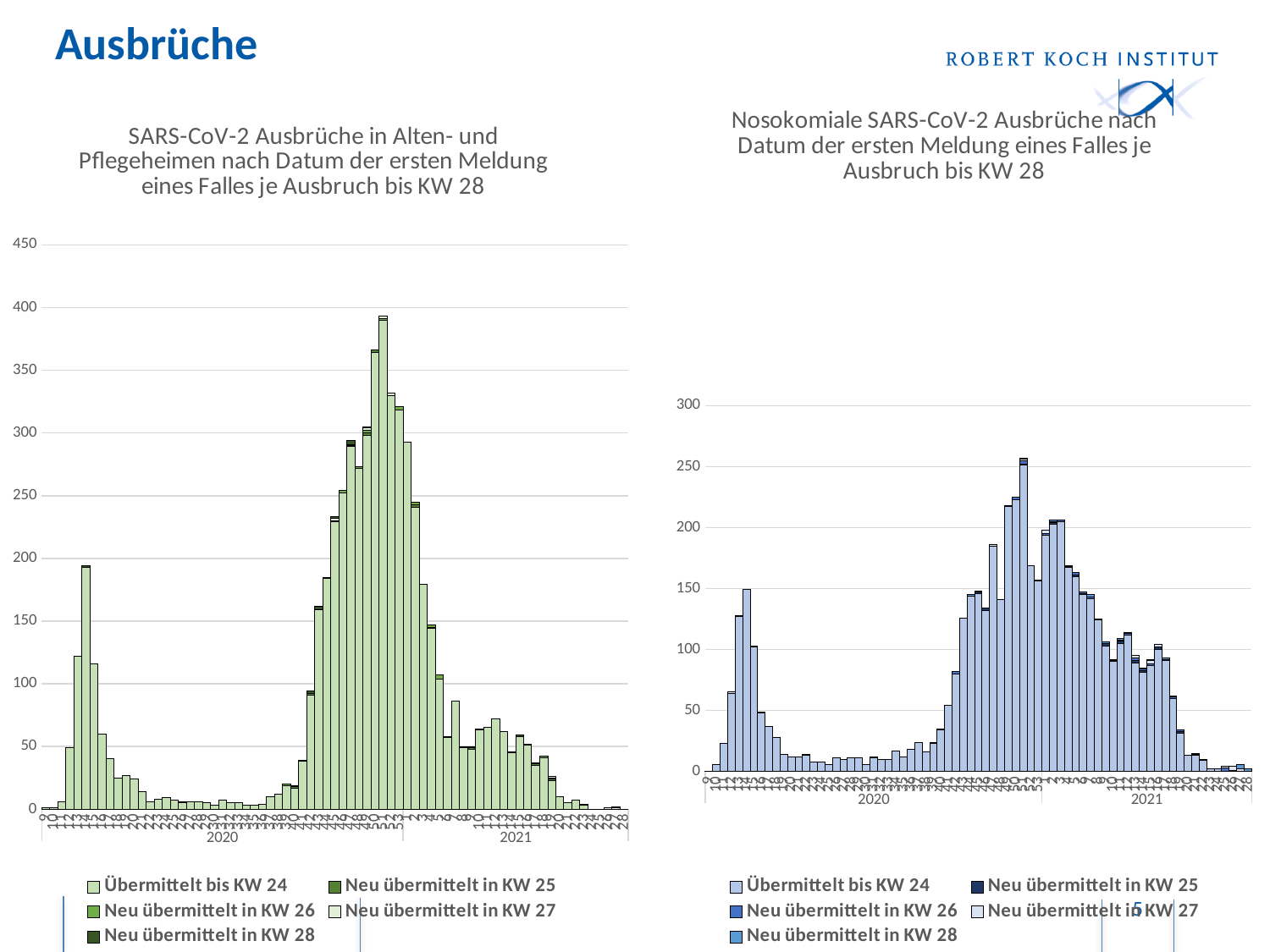
In the right chart (Nosokomiale Ausbrüche), is the tallest bar greater or less than 300? less What is the highest value shown on the y axis of the left chart (Alten- und Pflegeheime)? 450 What kind of chart is the right chart, 'Nosokomiale SARS-CoV-2 Ausbrüche'? Stacked bar chart Which chart has the higher peak bar, the left chart (Alten- und Pflegeheime) or the right chart (Nosokomiale Ausbrüche)? The left chart (Alten- und Pflegeheime) What kind of chart is the left chart, 'SARS-CoV-2 Ausbrüche in Alten- und Pflegeheimen'? Stacked bar chart In the left chart (Alten- und Pflegeheime), is the tallest bar greater or less than 400? less How many series does the legend of the right chart list? 5 Which two years are labelled on the x axis of the right chart (Nosokomiale Ausbrüche)? 2020 and 2021 How many series does the legend of the left chart list? 5 In the right chart (Nosokomiale Ausbrüche), is the tallest bar greater or less than 200? greater